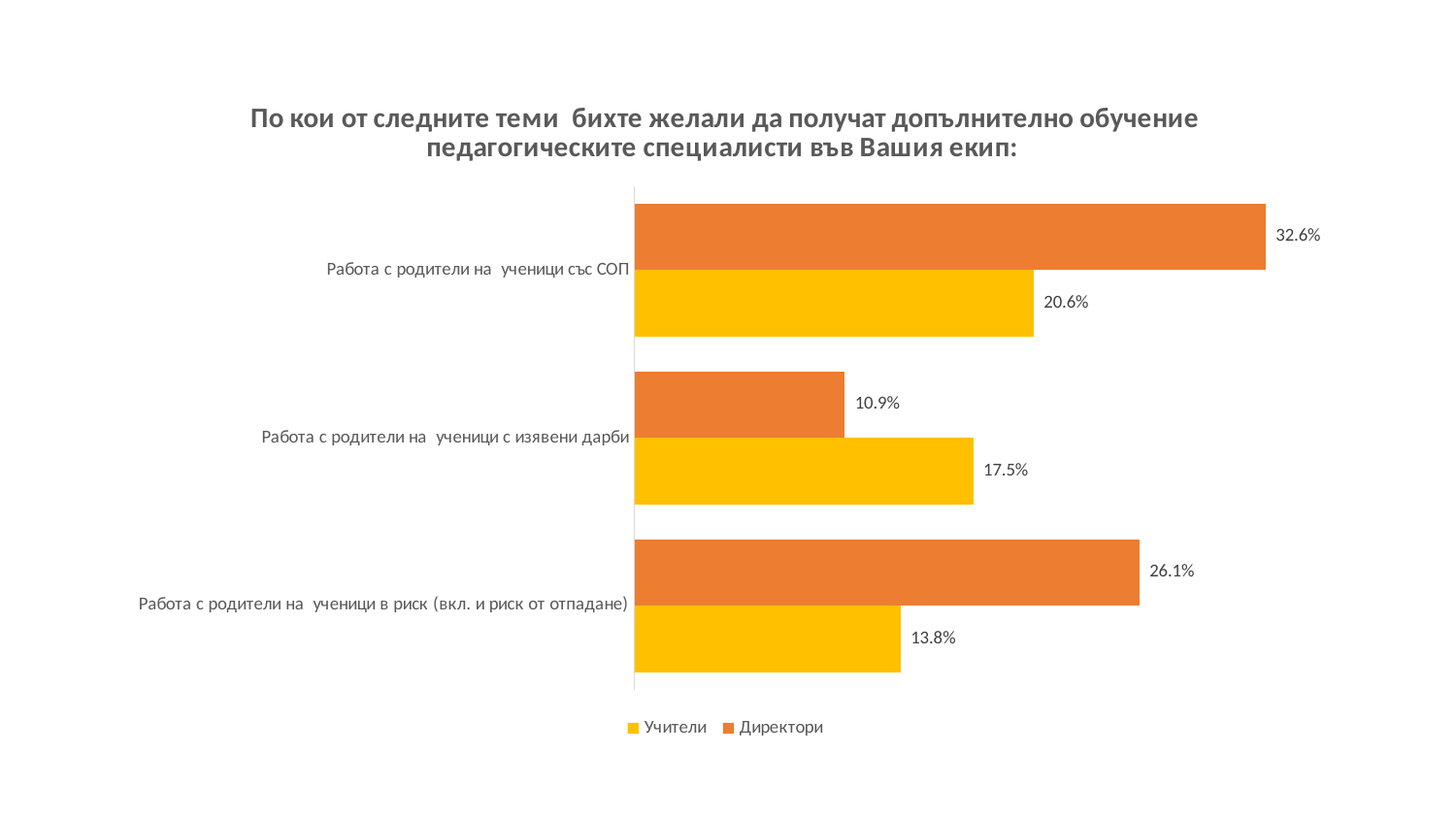
What is the value for Учители for 'Работа с родители на ученици в риск (вкл. и риск от отпадане)'? 13.8% Which series has the larger value for 'Работа с родители на ученици с изявени дарби', Учители or Директори? Учители What kind of chart is shown on the slide? Bar chart What is the value for Учители for 'Работа с родители на ученици с изявени дарби'? 17.5% What is the value for Директори for 'Работа с родители на ученици с изявени дарби'? 10.9% Which category has the highest value for Директори? Работа с родители на ученици със СОП Which category has the lowest value for Учители? Работа с родители на ученици в риск (вкл. и риск от отпадане) What is the value for Директори for 'Работа с родители на ученици със СОП'? 32.6% What is the difference between the Директори and Учители values for 'Работа с родители на ученици със СОП'? 12.0% Which colour represents the Директори series? Orange How many categories are shown in the chart? 3 How many series does the legend list? 2